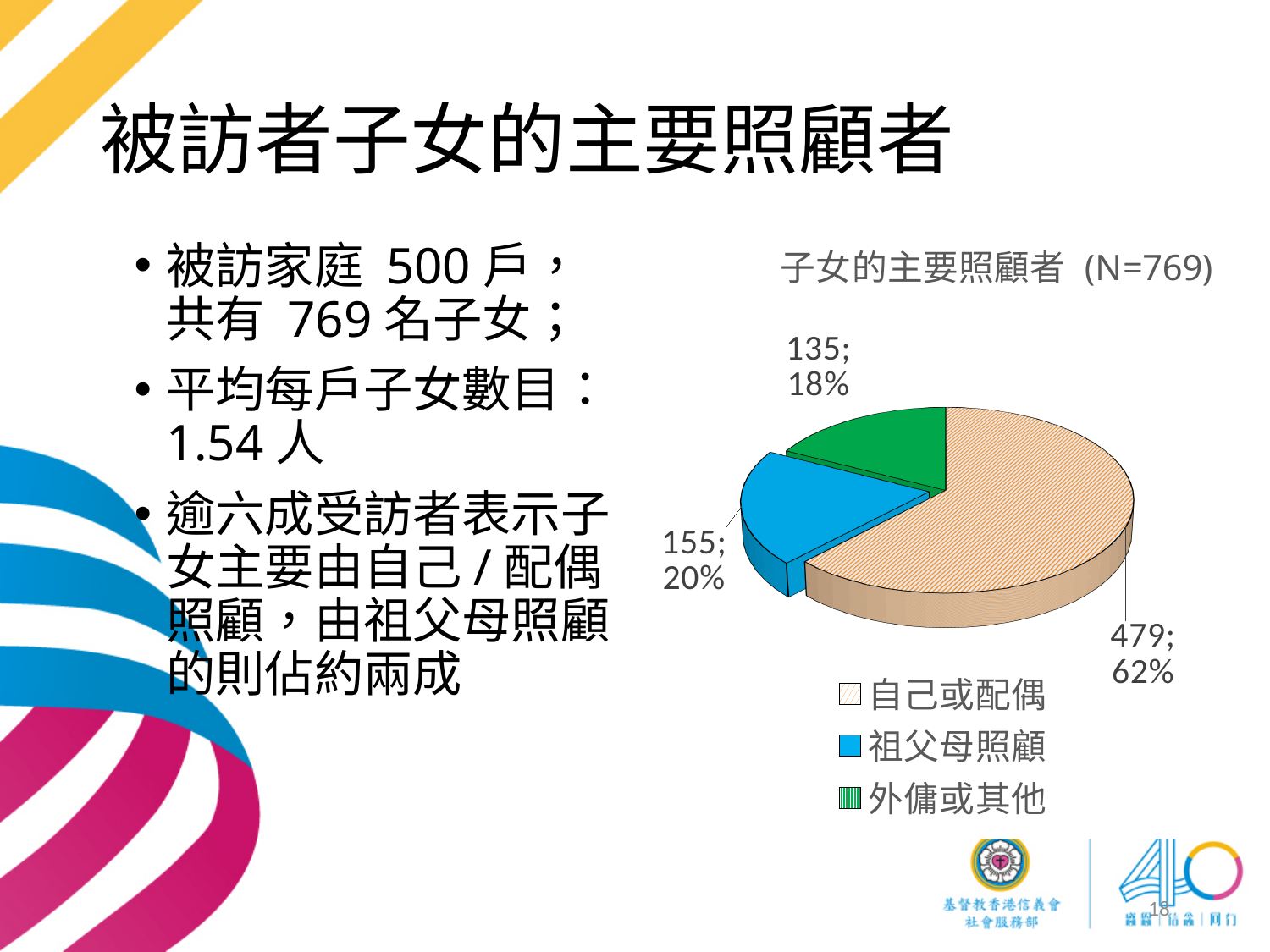
What is the difference in count between 自己或配偶 and 祖父母照顧? 324 What is the count for 自己或配偶? 479 Which category has the smallest slice? 外傭或其他 What kind of chart is shown on the slide? pie chart What is the count for 外傭或其他? 135 Which is larger, the count for 祖父母照顧 or the count for 外傭或其他? 祖父母照顧 Which category has the largest slice? 自己或配偶 What percentage share does 自己或配偶 have? 62% How many entries does the legend list? 3 What is the title of the chart? 子女的主要照顧者 (N=769) What percentage share does 祖父母照顧 have? 20% How many slices does the pie chart have? 3